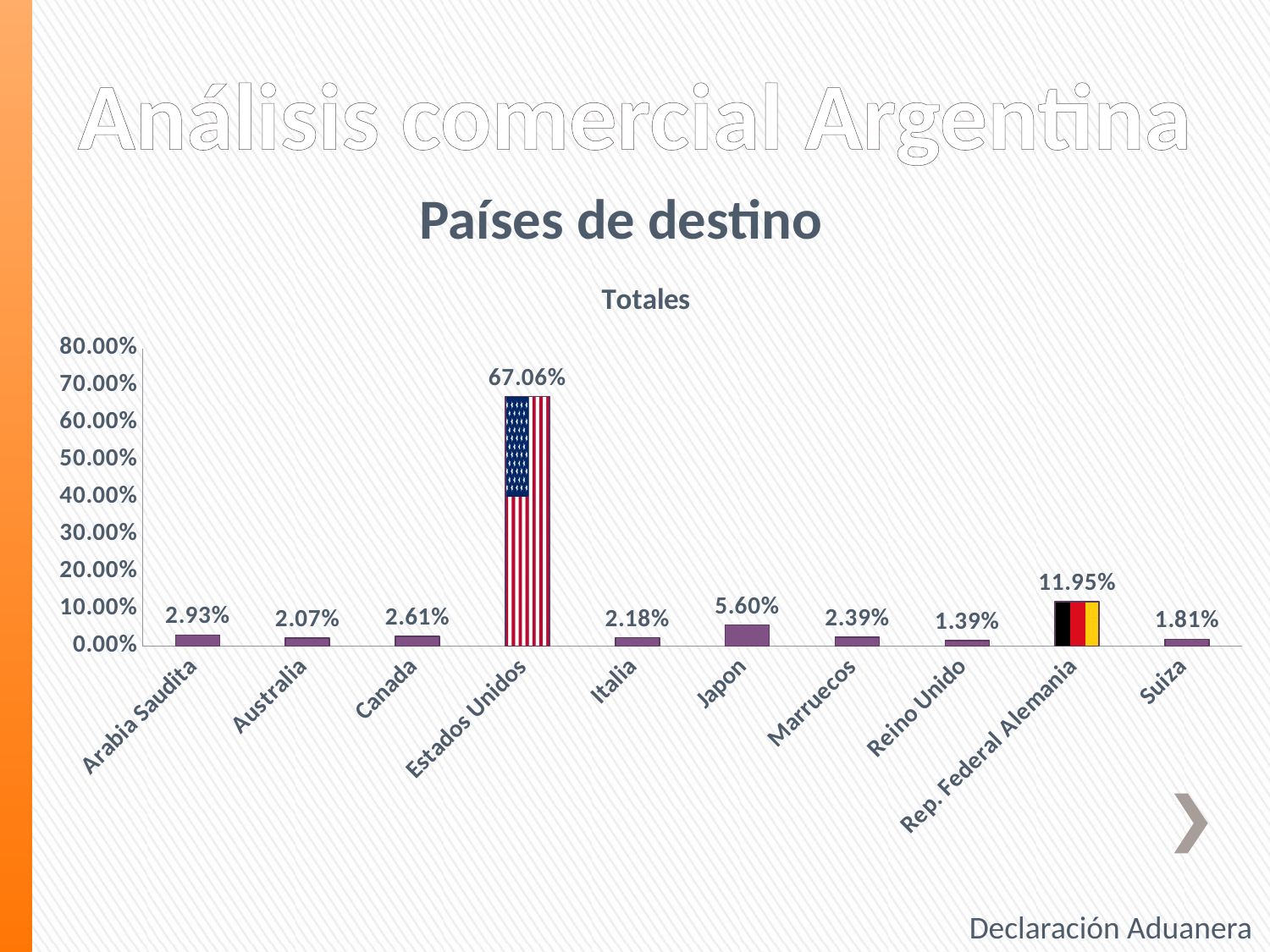
What is the title shown directly above the chart's plot area? Totales How many countries are shown on the x axis? 10 Which country has the lowest value? Reino Unido What is the value for Japon? 5.60% Is the value for Estados Unidos greater or less than 60.00%? greater Which country has the highest value? Estados Unidos Which is larger, the value for Arabia Saudita or the value for Canada? Arabia Saudita What is the value for Estados Unidos? 67.06% What is the value for Rep. Federal Alemania? 11.95% What is the difference between the values for Estados Unidos and Rep. Federal Alemania? 55.11% What is the value for Reino Unido? 1.39% What kind of chart is shown? bar chart